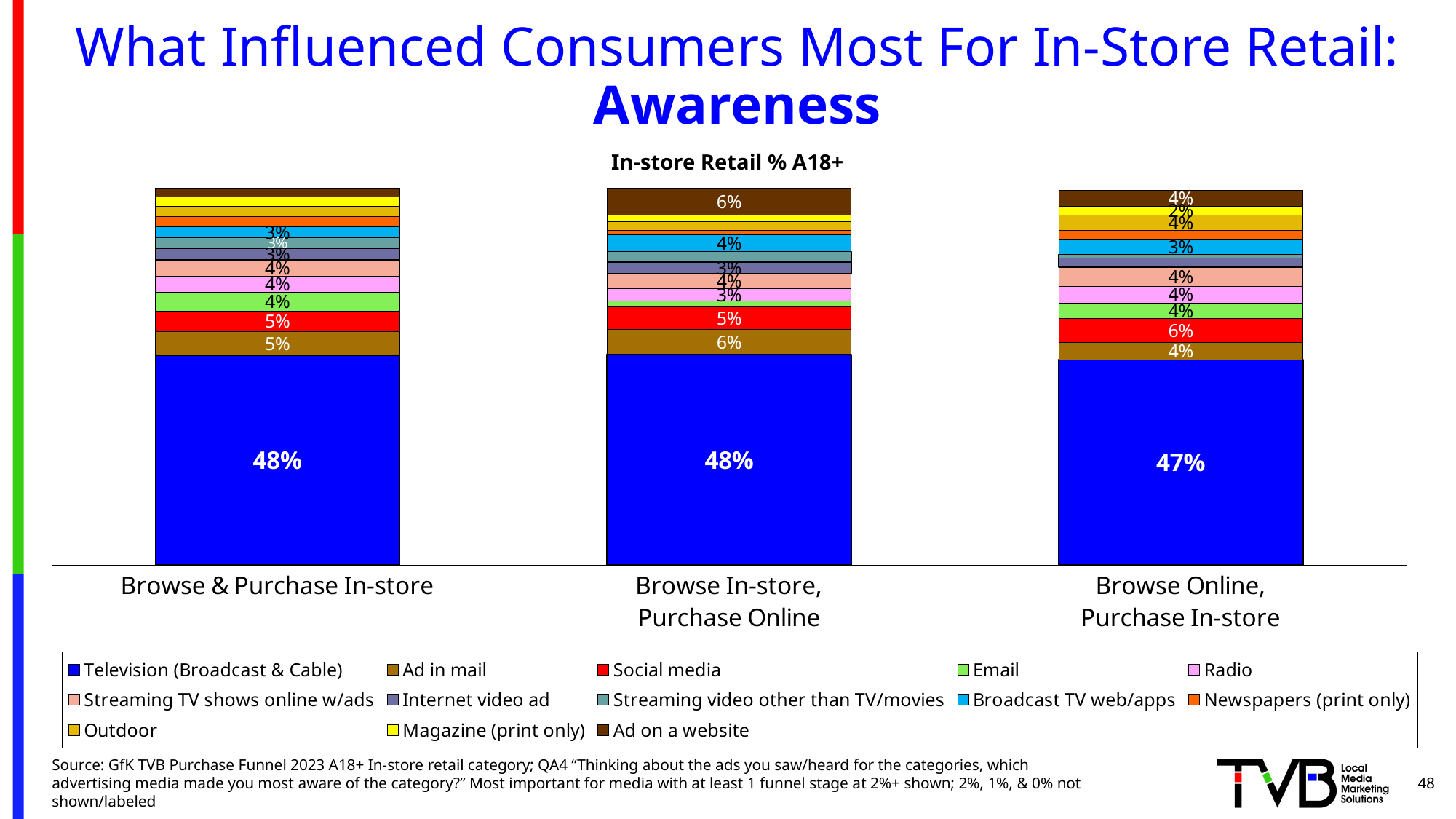
What is the title printed above the chart? In-store Retail % A18+ What is the Ad on a website value for Browse In-store, Purchase Online? 6% What is the difference between the Television (Broadcast & Cable) value for Browse & Purchase In-store and for Browse Online, Purchase In-store? 1 percentage point What is the Social media value for Browse Online, Purchase In-store? 6% Which category has the lowest Television (Broadcast & Cable) value? Browse Online, Purchase In-store Which has the larger Ad in mail value: Browse In-store, Purchase Online or Browse Online, Purchase In-store? Browse In-store, Purchase Online What is the Magazine (print only) value for Browse Online, Purchase In-store? 2% What is the Ad in mail value for Browse & Purchase In-store? 5% What kind of chart is shown on the slide? Stacked bar chart What is the Television (Broadcast & Cable) value for Browse Online, Purchase In-store? 47% How many series does the legend list? 13 How many categories (bars) are shown along the x axis? 3